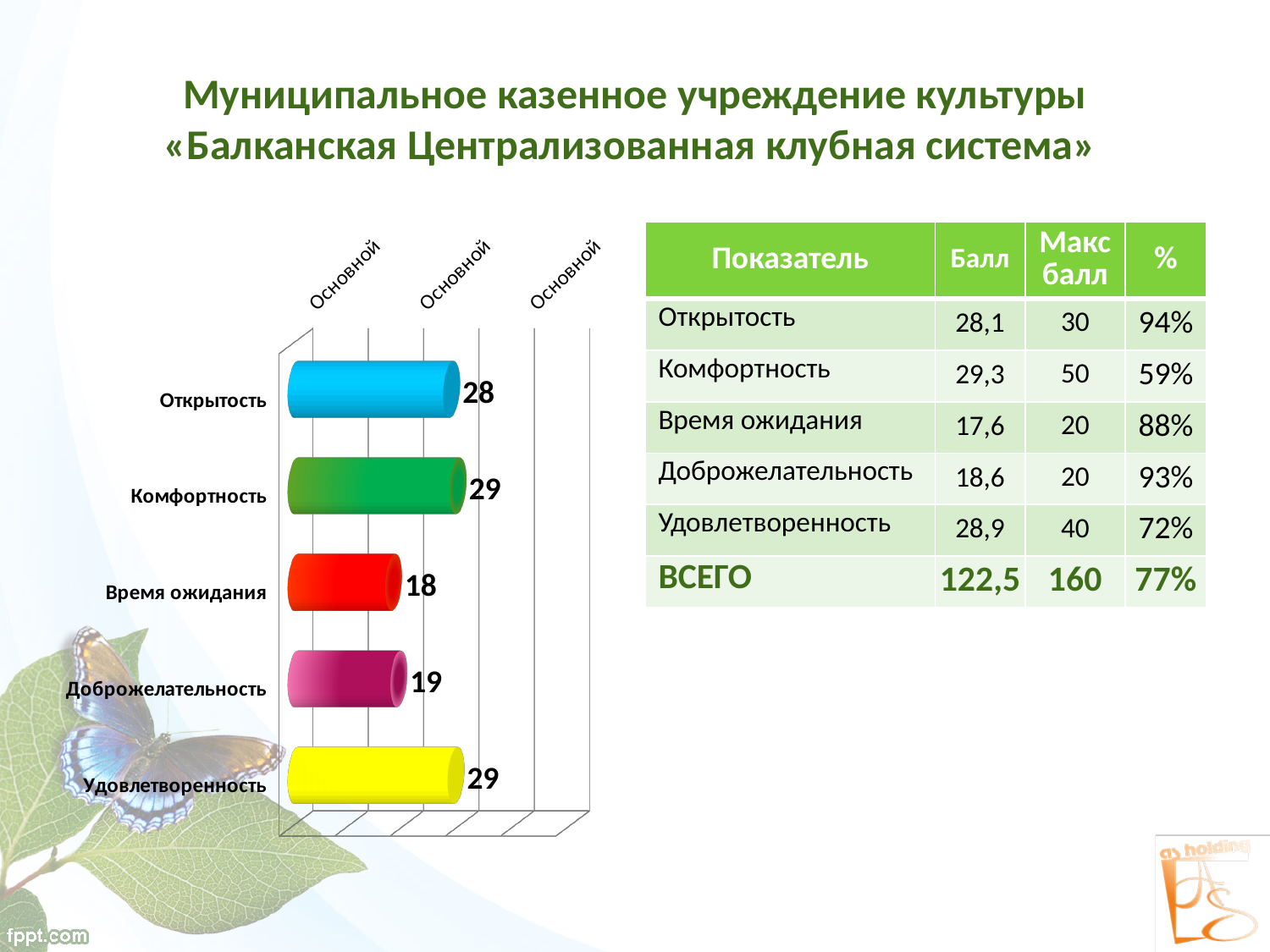
What is the difference between the values for Открытость and Время ожидания in the bar chart? 10 What is the difference between the values for Доброжелательность and Время ожидания in the bar chart? 1 What value is shown for Доброжелательность in the bar chart? 19 What colour is the bar for Удовлетворенность in the bar chart? Yellow What value is shown for Комфортность in the bar chart? 29 What kind of chart is shown on the left of the slide? Bar chart In the bar chart, which is larger: the value for Открытость or the value for Доброжелательность? Открытость What value is shown for Удовлетворенность in the bar chart? 29 What value is shown for Время ожидания in the bar chart? 18 How many categories are shown in the bar chart? 5 What value is shown for Открытость in the bar chart? 28 Which category has the lowest value in the bar chart? Время ожидания